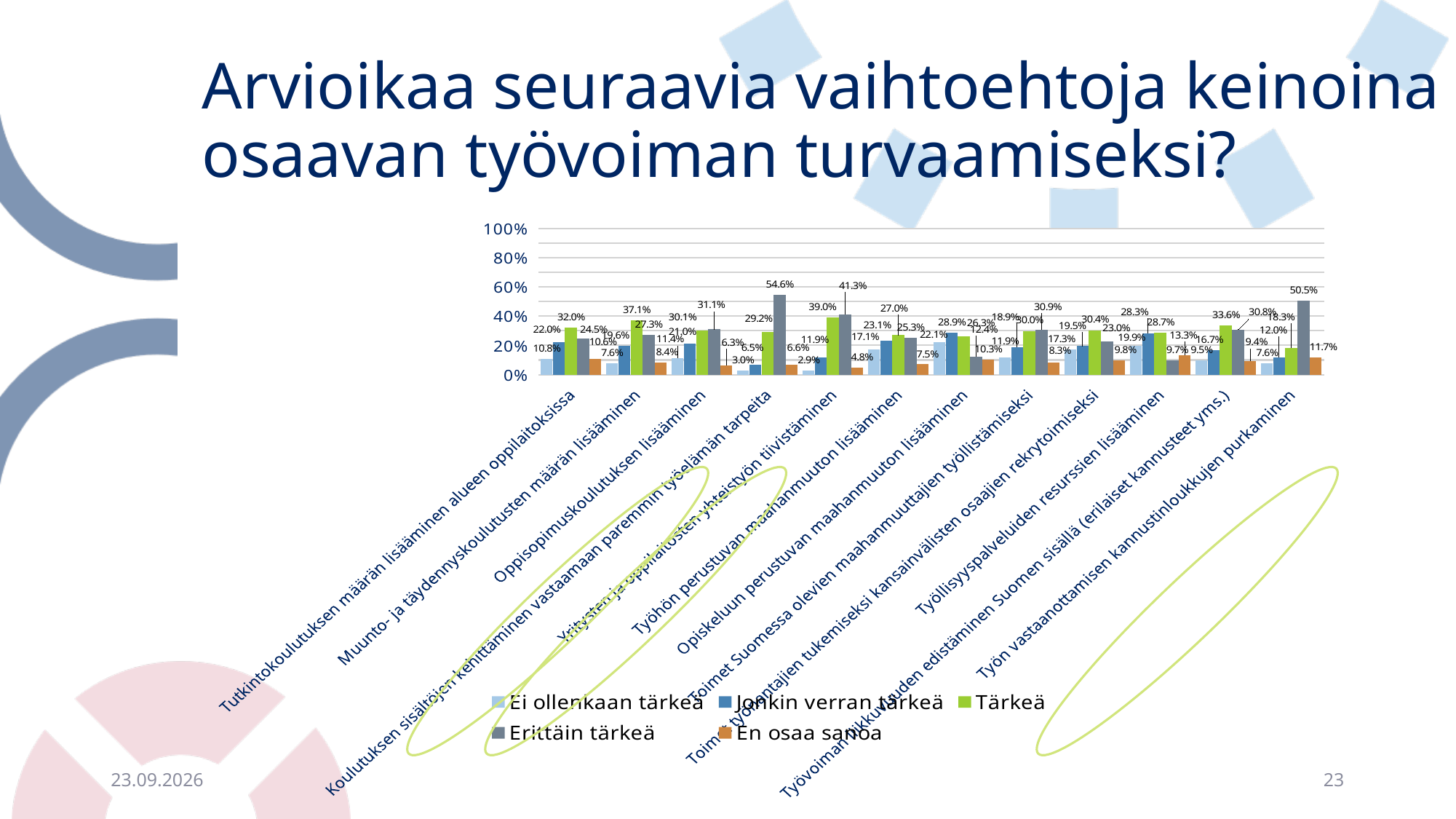
What is the difference between the 'Erittäin tärkeä' values for 'Koulutuksen sisältöjen kehittäminen vastaamaan paremmin työelämän tarpeita' and 'Työn vastaanottamisen kannustinloukkujen purkaminen'? 4.1 percentage points What colour represents the 'Tärkeä' series in the legend? Green Is the 'Erittäin tärkeä' value for 'Koulutuksen sisältöjen kehittäminen vastaamaan paremmin työelämän tarpeita' greater or less than 40%? greater Which category has the highest 'Erittäin tärkeä' value? Koulutuksen sisältöjen kehittäminen vastaamaan paremmin työelämän tarpeita What is the 'Erittäin tärkeä' value for 'Koulutuksen sisältöjen kehittäminen vastaamaan paremmin työelämän tarpeita'? 54.6% What kind of chart is shown on the slide? Bar chart What is the 'Erittäin tärkeä' value for 'Työn vastaanottamisen kannustinloukkujen purkaminen'? 50.5% How many series does the legend list? 5 How many categories are shown on the x axis of the chart? 12 Which has the larger 'Tärkeä' value: 'Muunto- ja täydennyskoulutusten määrän lisääminen' or 'Tutkintokoulutuksen määrän lisääminen alueen oppilaitoksissa'? Muunto- ja täydennyskoulutusten määrän lisääminen What is the 'Tärkeä' value for 'Yritysten ja oppilaitosten yhteistyön tiivistäminen'? 39.0% What is the 'Tärkeä' value for 'Työvoiman liikkuvuuden edistäminen Suomen sisällä (erilaiset kannusteet yms.)'? 33.6%